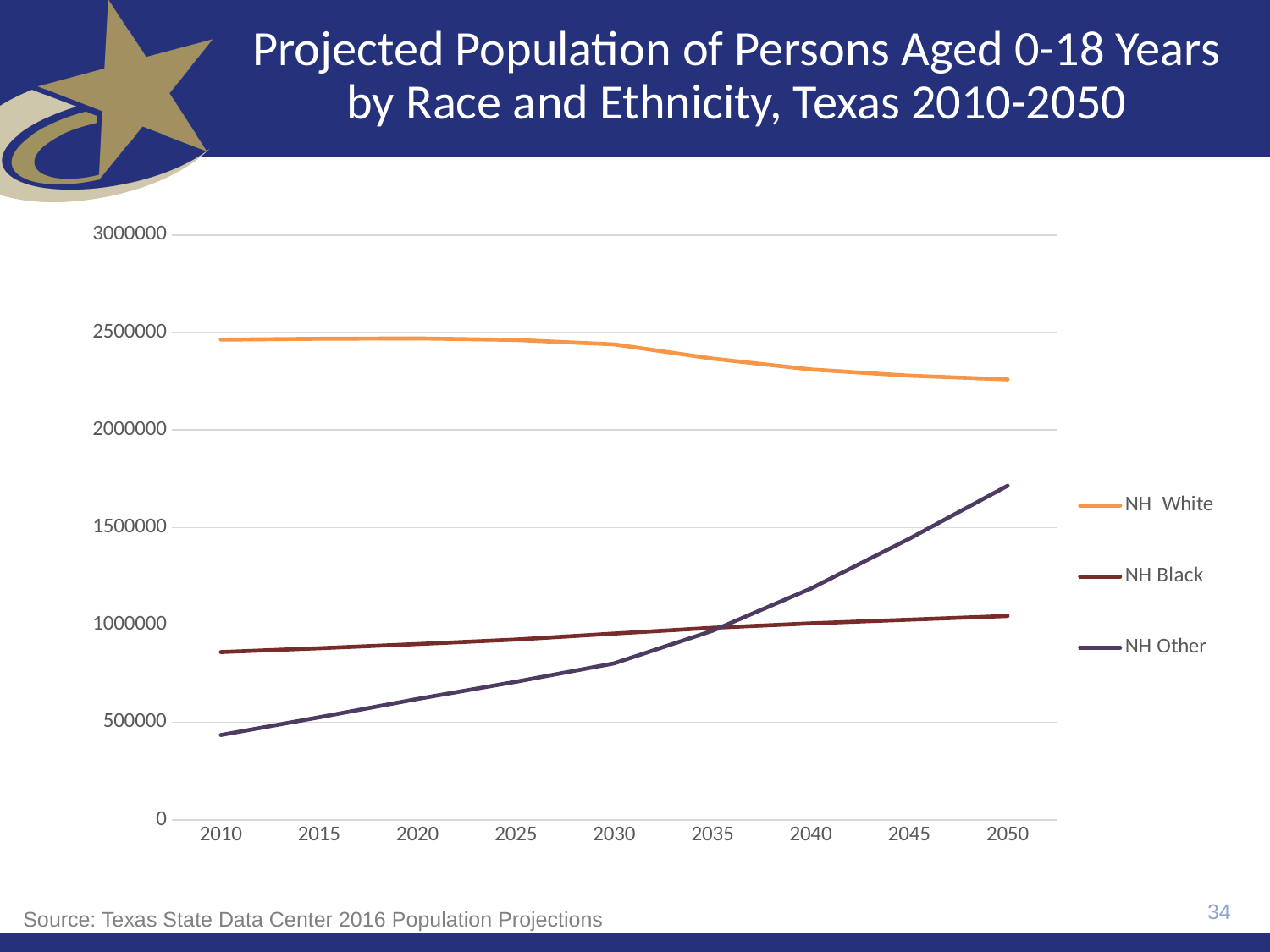
Which series has the highest value in 2050? NH White Is the value for NH Other in 2050 greater or less than 1500000? greater What is the title of the chart? Projected Population of Persons Aged 0-18 Years by Race and Ethnicity, Texas 2010-2050 In 2050, which is larger, NH Black or NH Other? NH Other Is the value for NH White in 2010 greater or less than 2000000? greater Does the NH Other series rise or fall from 2010 to 2050? rise Which series has the lowest value in 2010? NH Other How many years are labelled on the x axis? 9 Does the NH White series rise or fall from 2030 to 2050? fall What kind of chart is shown on the slide? line chart How many series does the legend list? 3 Is the value for NH Other in 2010 greater or less than 500000? less